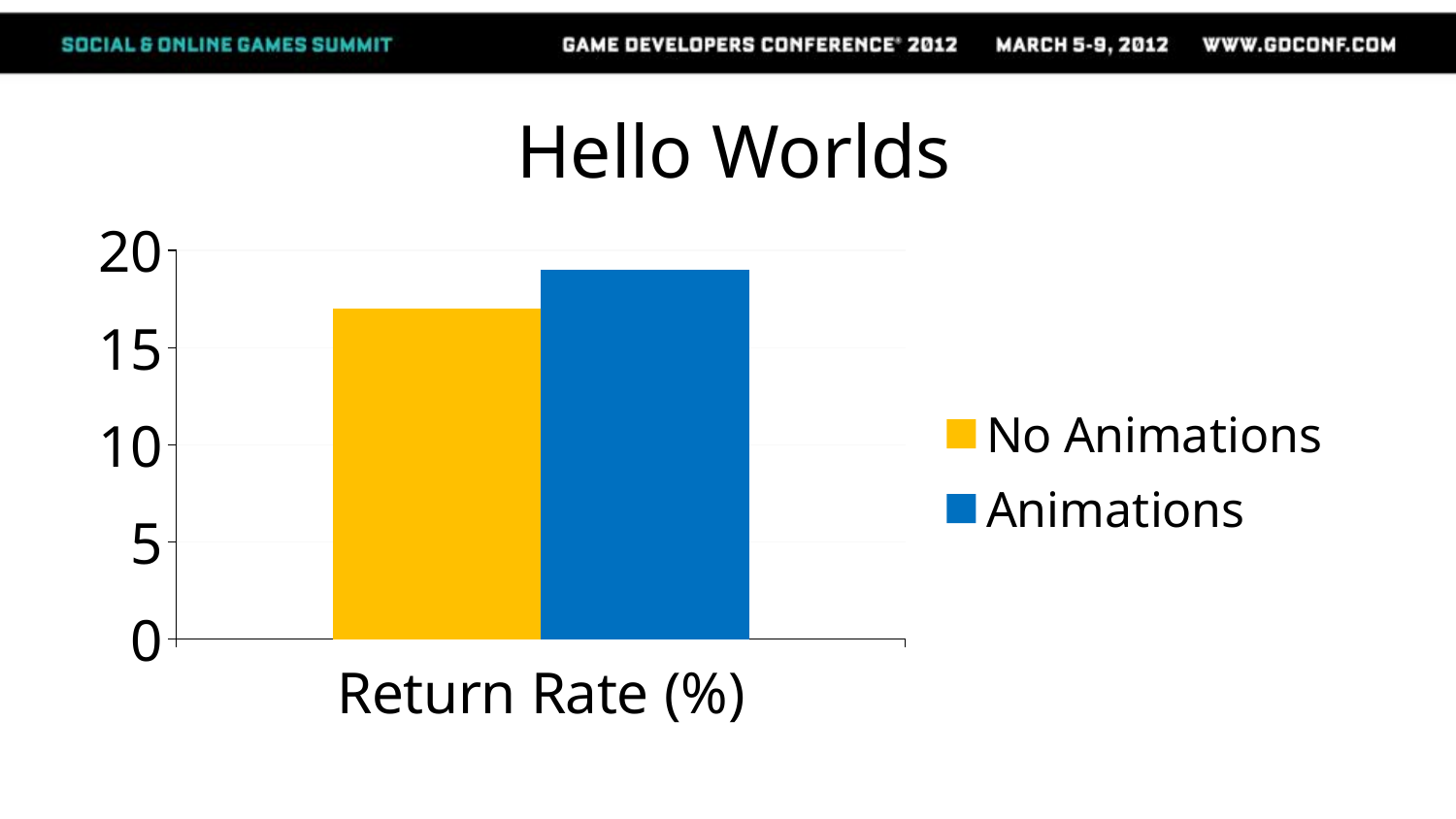
Which legend entry is shown in blue? Animations Which series has the lowest bar? No Animations Is the value for No Animations greater or less than 15? greater How many series does the legend list? 2 Is the value for Animations greater or less than 15? greater What is the label of the category on the x axis? Return Rate (%) Is the value for No Animations greater or less than 20? less Which series has the higher return rate, No Animations or Animations? Animations Which series has the highest bar? Animations How many categories are shown on the x axis? 1 What kind of chart is shown on the slide? bar chart